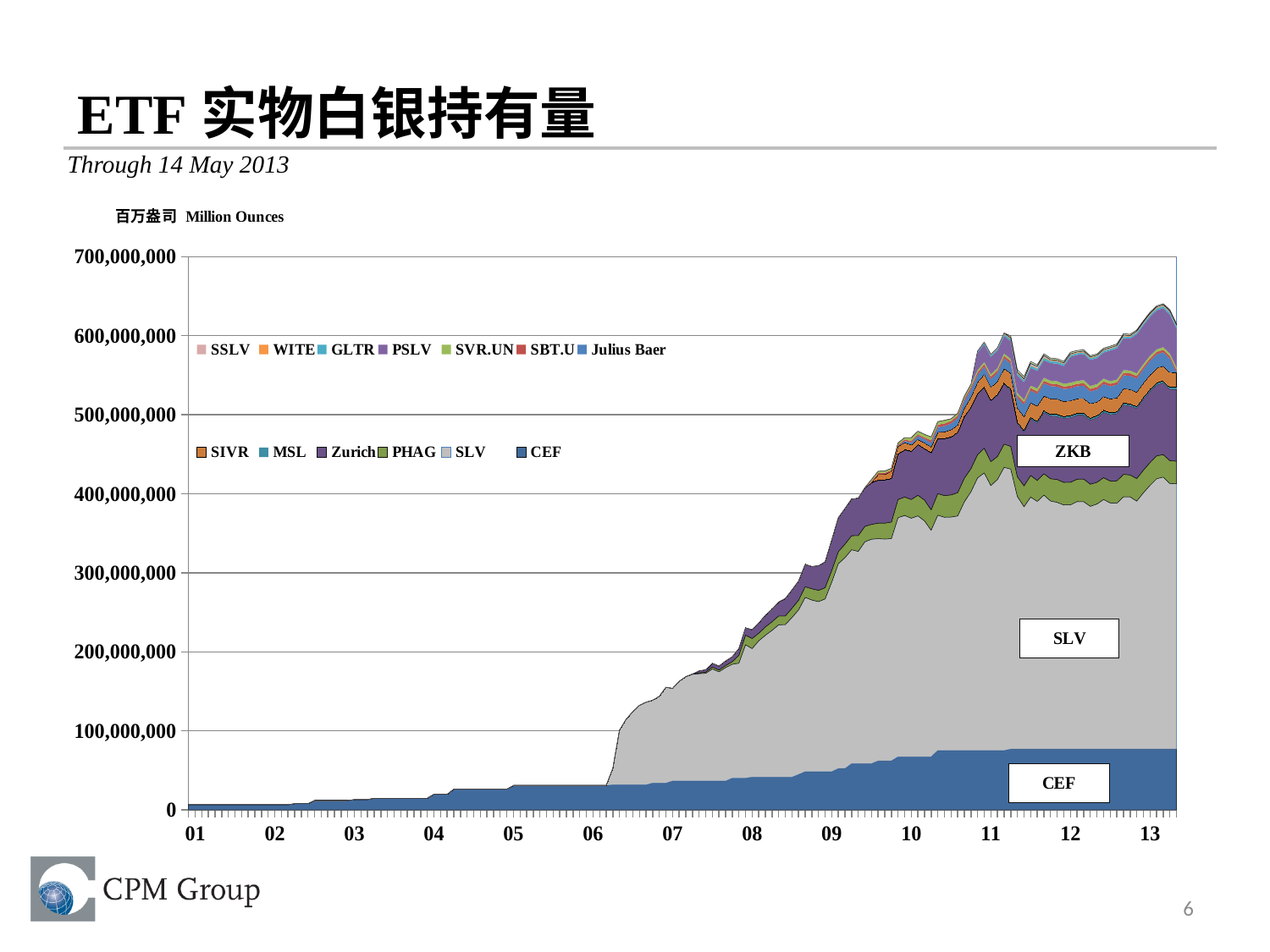
What unit is stated above the y axis? Million Ounces Is the total stacked value at 05 greater or less than 100,000,000? less Is the total stacked value at 13 greater or less than 600,000,000? greater What date is the chart data reported through, according to the subtitle? 14 May 2013 What kind of chart is shown on the slide? Stacked area chart Is the total stacked value at 07 greater or less than 100,000,000? greater Do total ETF silver holdings generally rise or fall from 01 to 13? Rise Which series accounts for the largest share of holdings in 13? SLV How many year labels are shown on the x axis? 13 How many series does the legend list? 13